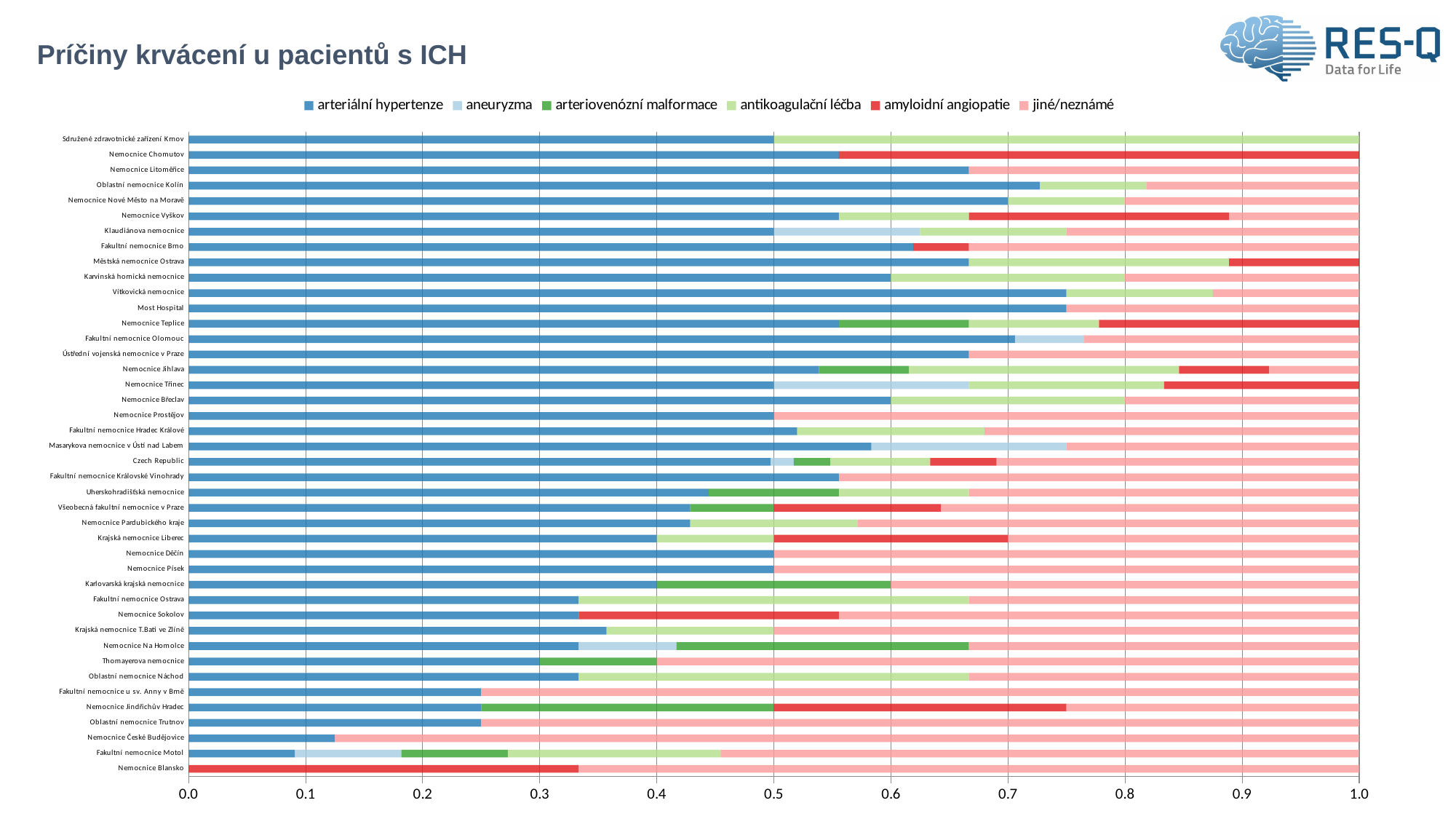
Which hospital has the largest jiné/neznámé share? Nemocnice České Budějovice Is the arteriální hypertenze value for Oblastní nemocnice Kolín greater or less than 0.7? greater What is the title of the chart? Príčiny krvácení u pacientů s ICH Which has the larger arteriální hypertenze share, Oblastní nemocnice Kolín or Fakultní nemocnice Ostrava? Oblastní nemocnice Kolín What kind of chart is shown on the slide? stacked bar chart How many series does the legend list? 6 Is the amyloidní angiopatie value for Nemocnice Chomutov greater or less than 0.4? greater What is the arteriální hypertenze value for Sdružené zdravotnické zařízení Krnov? 0.5 Which hospital has the lowest arteriální hypertenze share? Nemocnice Blansko Is the arteriovenózní malformace value for Nemocnice Jindřichův Hradec greater or less than 0.2? greater How many hospitals (categories) are plotted on the chart? 42